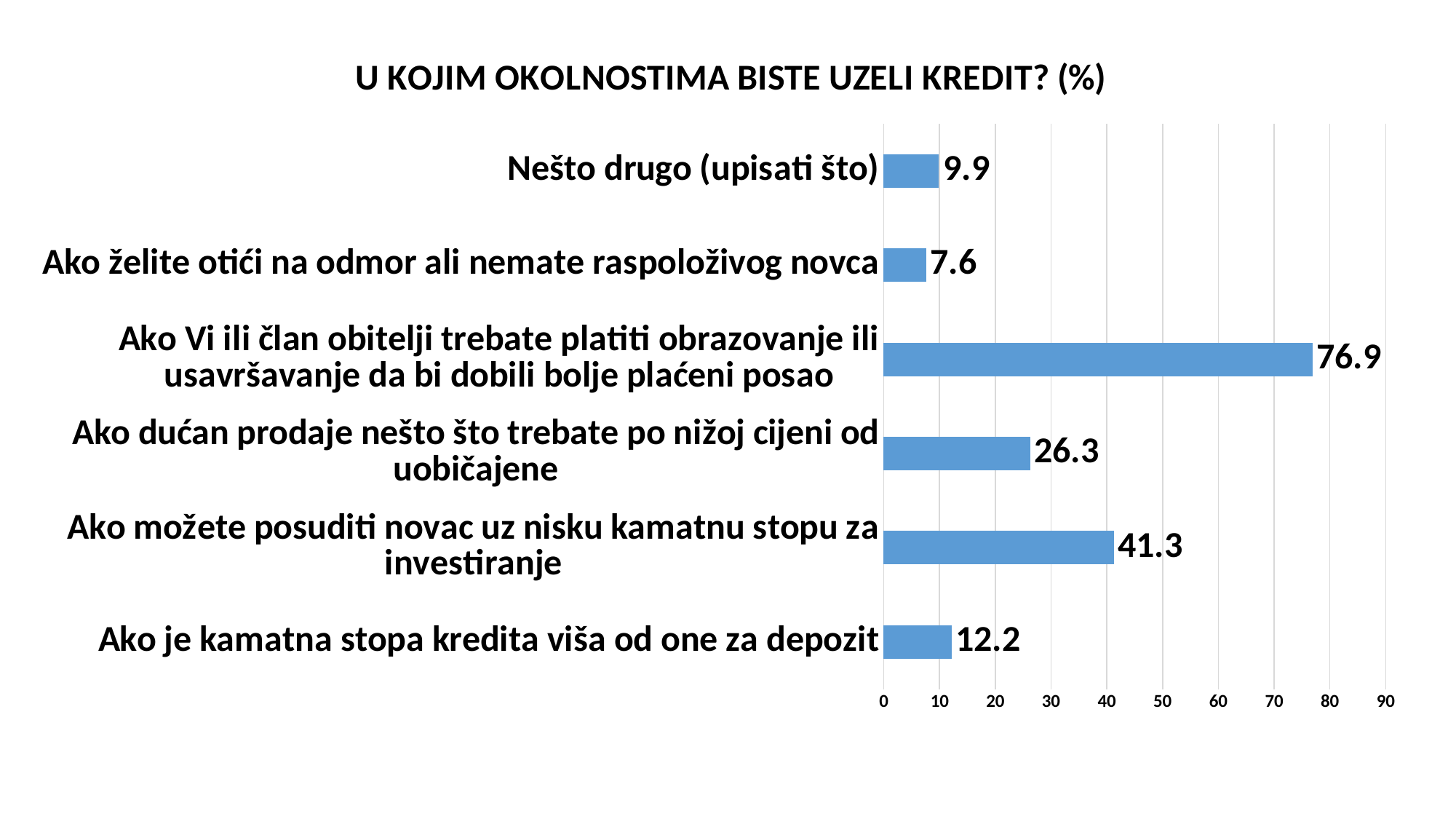
What kind of chart is shown on the slide? bar chart Which category has the lowest value? Ako želite otići na odmor ali nemate raspoloživog novca What is the value for "Nešto drugo (upisati što)"? 9.9 What is the title of the chart? U KOJIM OKOLNOSTIMA BISTE UZELI KREDIT? (%) How many categories are shown in the chart? 6 What is the difference between the values for "Ako Vi ili član obitelji trebate platiti obrazovanje ili usavršavanje da bi dobili bolje plaćeni posao" and "Ako možete posuditi novac uz nisku kamatnu stopu za investiranje"? 35.6 What is the value for "Ako možete posuditi novac uz nisku kamatnu stopu za investiranje"? 41.3 What is the value for "Ako želite otići na odmor ali nemate raspoloživog novca"? 7.6 Which is larger: the value for "Ako dućan prodaje nešto što trebate po nižoj cijeni od uobičajene" or for "Ako je kamatna stopa kredita viša od one za depozit"? Ako dućan prodaje nešto što trebate po nižoj cijeni od uobičajene Which category has the highest value? Ako Vi ili član obitelji trebate platiti obrazovanje ili usavršavanje da bi dobili bolje plaćeni posao Is the value for "Ako dućan prodaje nešto što trebate po nižoj cijeni od uobičajene" greater or less than 20? greater What is the value for "Ako je kamatna stopa kredita viša od one za depozit"? 12.2